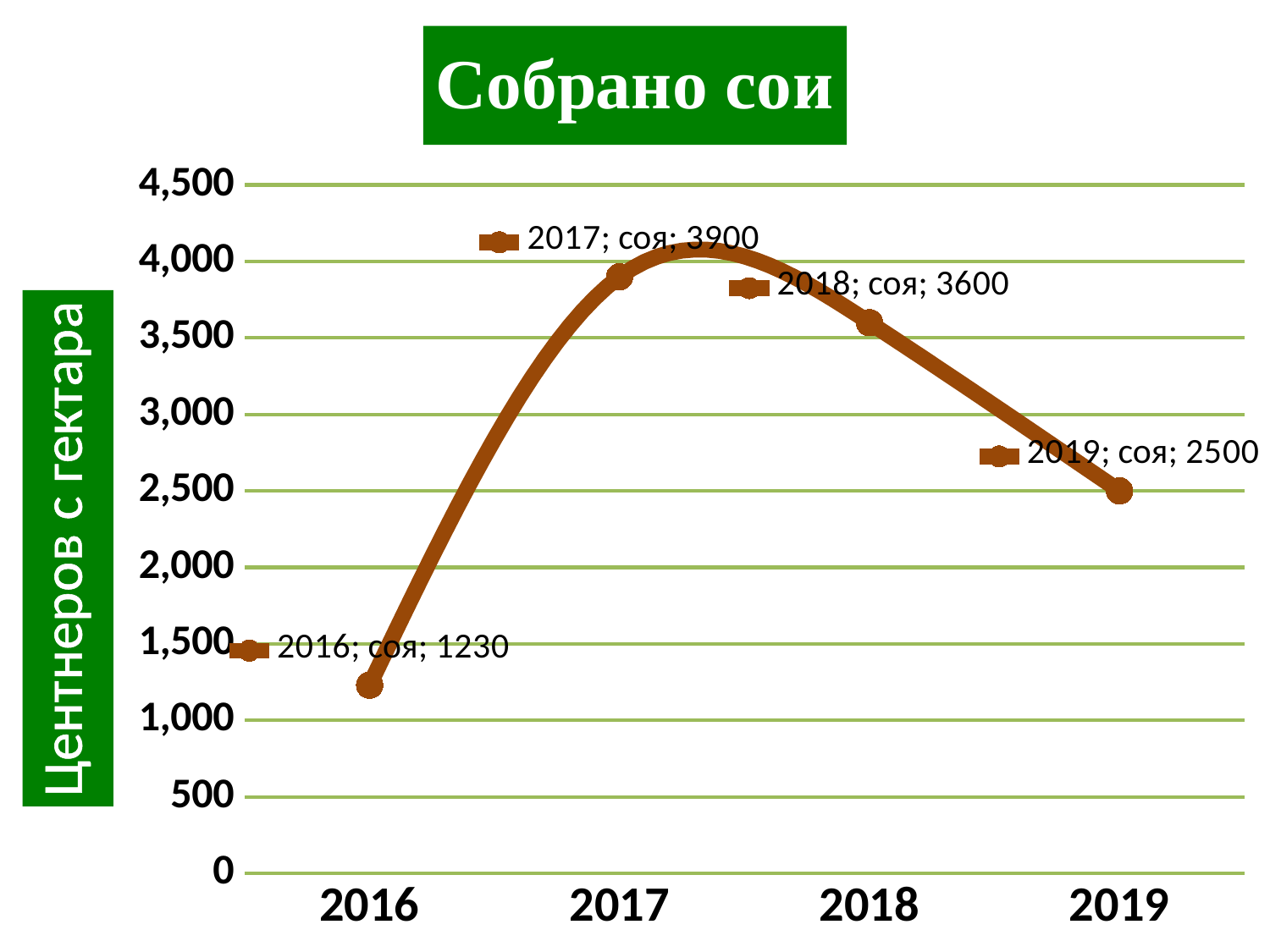
What is the value for 2017? 3900 How many data points are plotted on the chart? 4 What is the value for 2016? 1230 What is the value for 2019? 2500 What kind of chart is shown? line chart Do the values rise or fall from 2017 to 2019? fall What is the difference between the values for 2017 and 2018? 300 What is the title of the chart? Собрано сои Which year has the highest value? 2017 What is the difference between the values for 2018 and 2019? 1100 Which year has the lowest value? 2016 Which is larger, the value for 2018 or the value for 2019? 2018